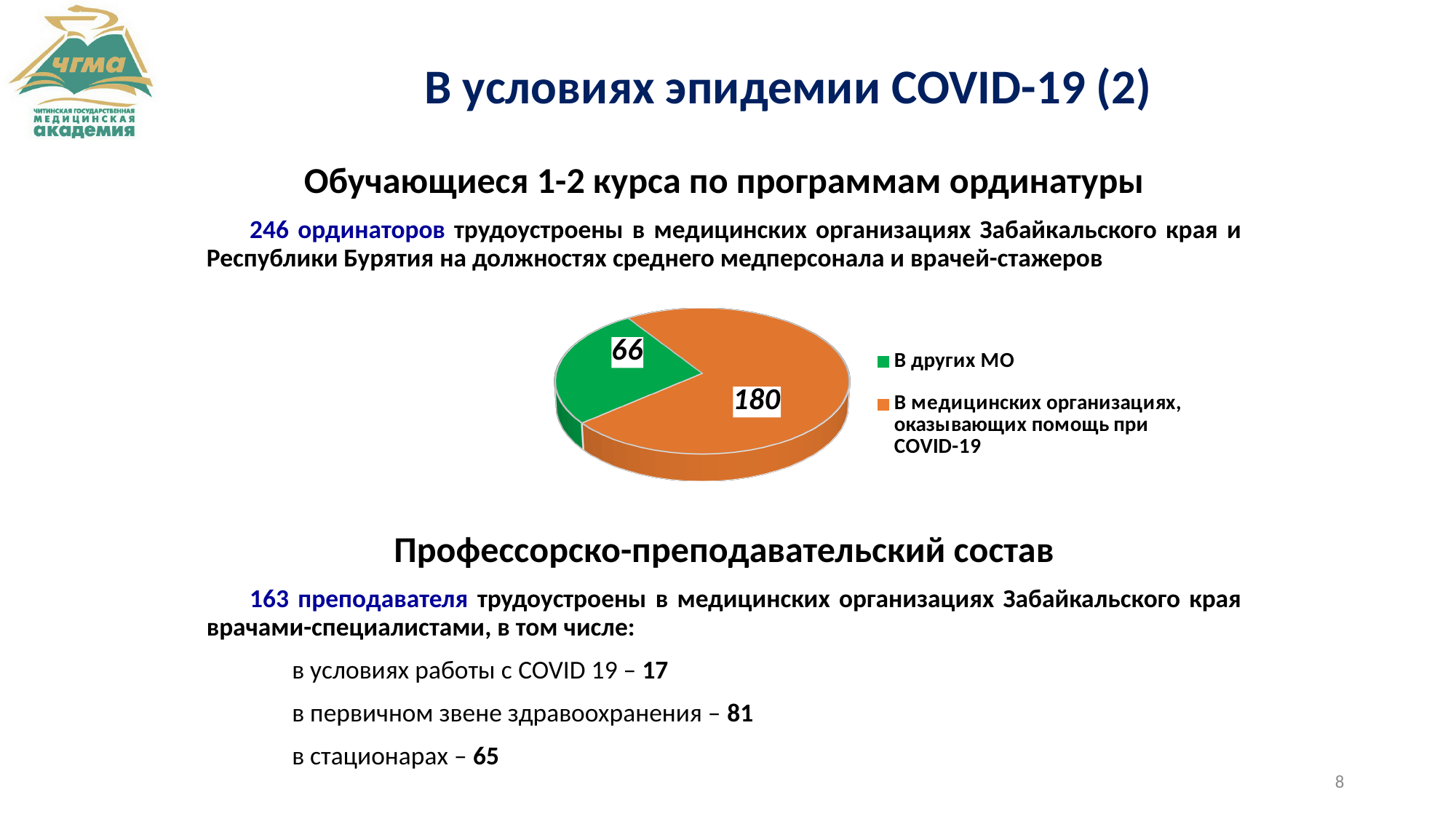
What is the total of the two values shown in the pie chart? 246 How many entries does the legend of the pie chart list? 2 Which is larger: the value for "В других МО" or the value for "В медицинских организациях, оказывающих помощь при COVID-19"? В медицинских организациях, оказывающих помощь при COVID-19 Which slice of the pie chart is the smallest? В других МО What is the value for the slice "В других МО"? 66 What is the value for the slice "В медицинских организациях, оказывающих помощь при COVID-19"? 180 What colour is the slice for "В других МО"? green What kind of chart is shown on the slide? pie chart What colour is the slice for "В медицинских организациях, оказывающих помощь при COVID-19"? orange Which slice of the pie chart is the largest? В медицинских организациях, оказывающих помощь при COVID-19 How many slices does the pie chart have? 2 What is the difference between the value for "В медицинских организациях, оказывающих помощь при COVID-19" and the value for "В других МО"? 114